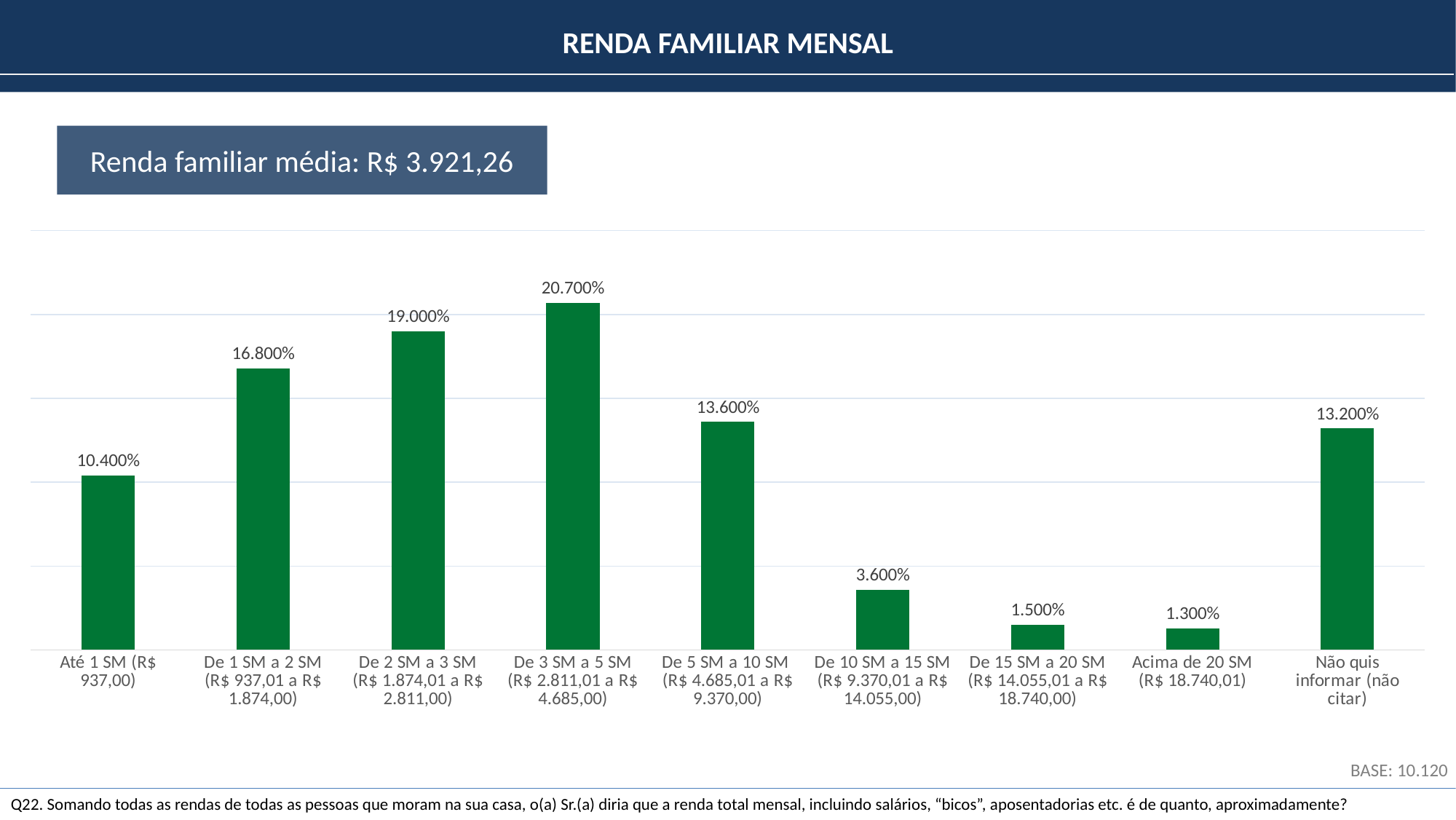
What is the base (number of respondents) shown on the slide? 10.120 Do the values rise or fall from 'Até 1 SM' through 'De 3 SM a 5 SM'? Rise What percentage of respondents reported a monthly family income of 'Até 1 SM (R$ 937,00)'? 10.400% How many income categories are plotted on the chart? 9 What percentage is shown for 'Não quis informar (não citar)'? 13.200% Which income category has the lowest value? Acima de 20 SM (R$ 18.740,01) What type of chart is shown on the slide? Bar chart Which income category has the highest bar? De 3 SM a 5 SM (R$ 2.811,01 a R$ 4.685,00) Which is larger: the value for 'De 1 SM a 2 SM' or the value for 'De 5 SM a 10 SM'? De 1 SM a 2 SM What is the average family income stated on the slide? R$ 3.921,26 What is the value shown for the 'De 5 SM a 10 SM' category? 13.600% What is the difference between the values for 'De 3 SM a 5 SM' and 'De 2 SM a 3 SM'? 1.700%